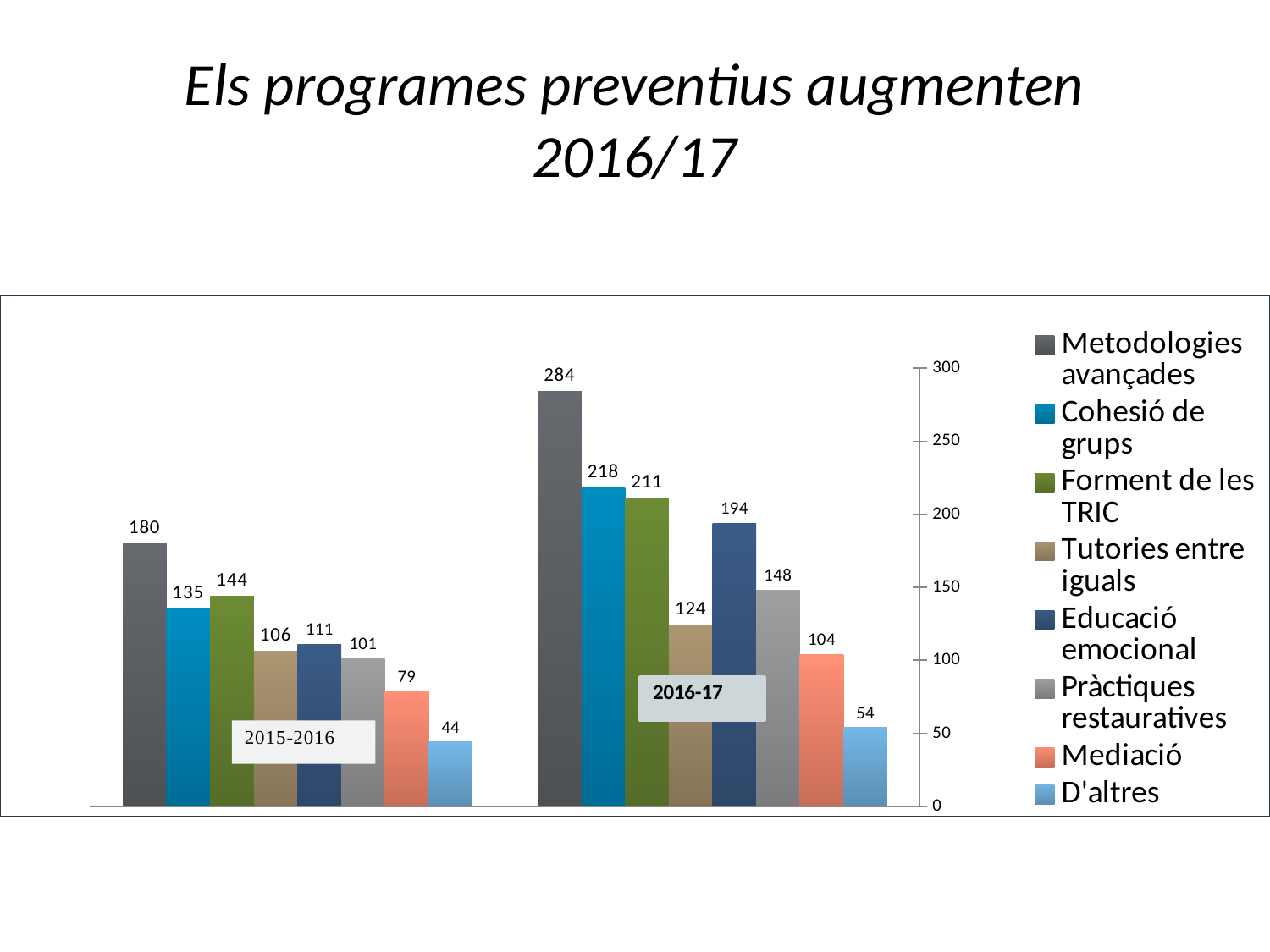
What is the difference between Tutories entre iguals in 2016-17 and in 2015-2016? 18 How many groups of bars (periods) are shown on the x axis? 2 What is the value for Metodologies avançades in 2016-17? 284 What kind of chart is shown on the slide? bar chart Which is larger in 2015-2016: Forment de les TRIC or Cohesió de grups? Forment de les TRIC How many series does the legend list? 8 Which series has the highest value in the 2016-17 group? Metodologies avançades Is the value for Pràctiques restauratives in 2016-17 greater or less than 100? greater What is the value for Educació emocional in 2016-17? 194 What is the difference between the Cohesió de grups values for 2016-17 and 2015-2016? 83 Which series has the lowest value in the 2015-2016 group? D'altres What is the value for Mediació in 2015-2016? 79